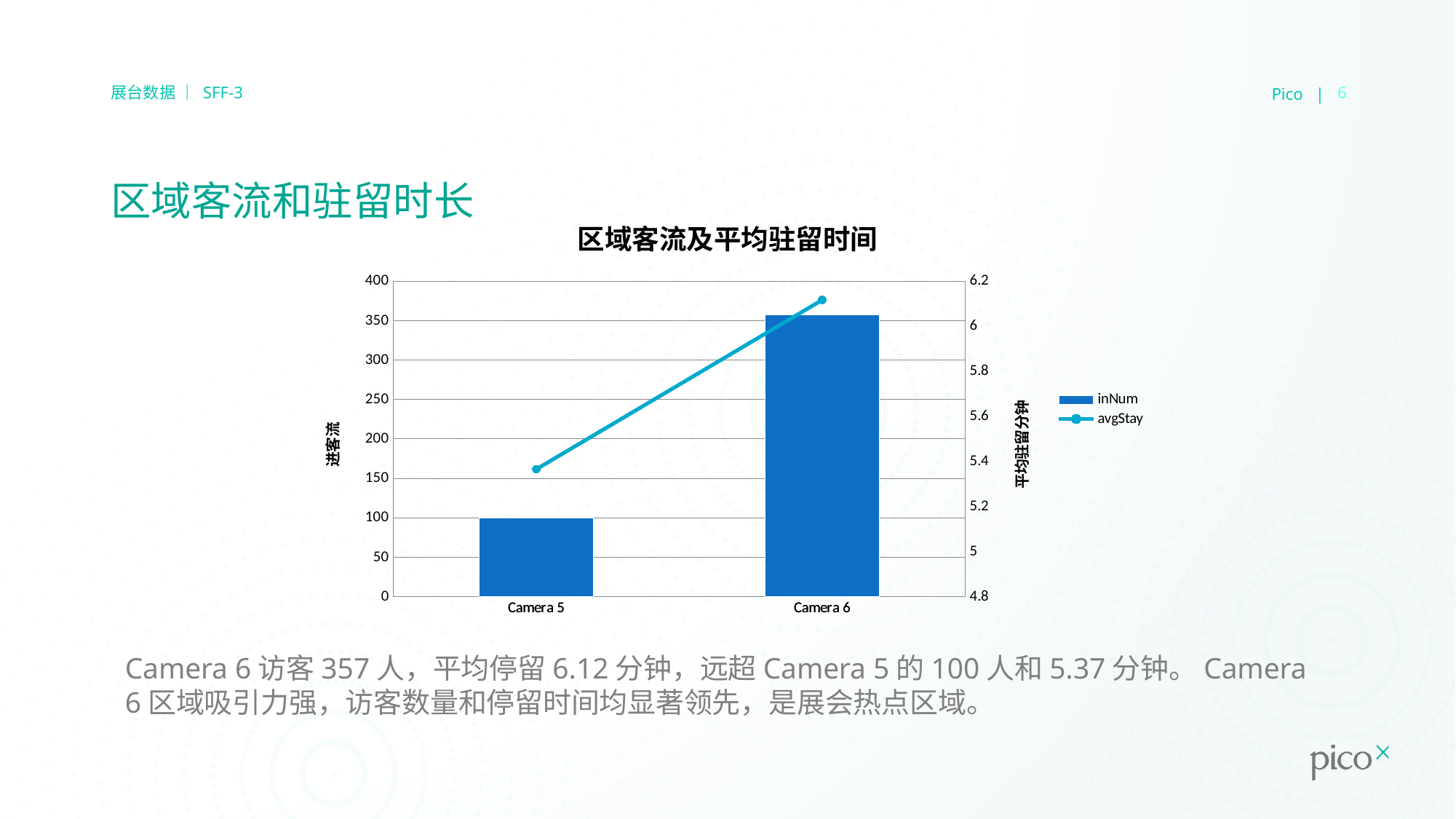
Which category has the lowest avgStay value? Camera 5 What is the inNum value for Camera 5? 100 Which category has the highest inNum value? Camera 6 What is the inNum value for Camera 6? 357 Is the inNum value for Camera 6 greater or less than 300? greater How many series does the chart legend list? 2 What is the avgStay value for Camera 5? 5.37 What is the title of the chart? 区域客流及平均驻留时间 How many categories are shown on the x axis of the chart? 2 What is the difference in inNum between Camera 6 and Camera 5? 257 Does the avgStay line rise or fall from Camera 5 to Camera 6? rise What is the avgStay value for Camera 6? 6.12